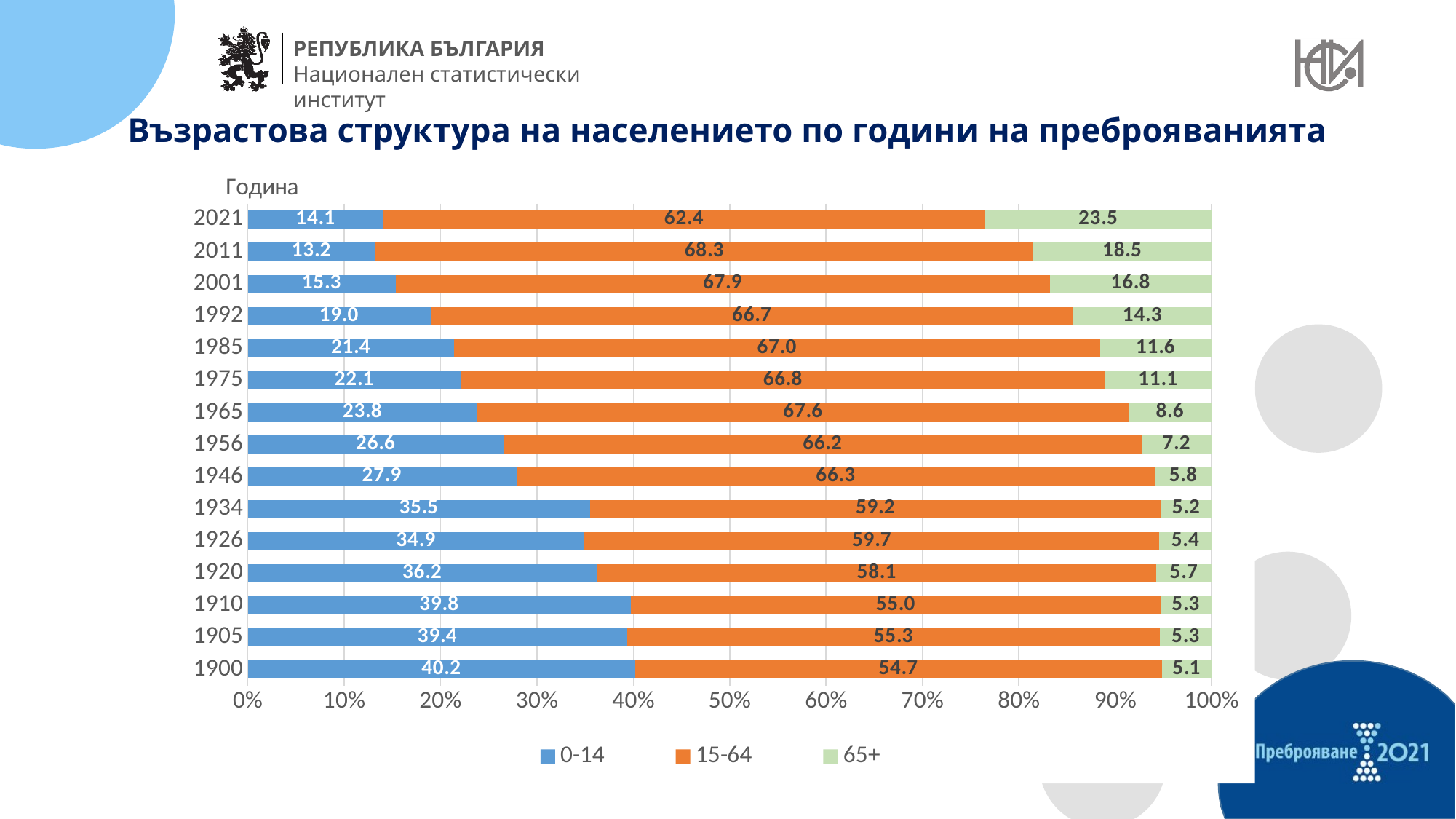
How many census years are shown on the chart? 15 What is the value for the 15-64 group in 1992? 66.7 What type of chart is shown on the slide? Stacked bar chart In which year is the 15-64 share the highest? 2011 Does the 0-14 share rise or fall from 1900 to 2021 (bottom to top of the chart)? Falls What is the difference between the 65+ values for 2021 and 2011? 5.0 What is the value for the 65+ group in 2021? 23.5 Which is larger: the 0-14 value for 1985 or for 1992? 1985 How many series does the legend list? 3 In which year is the 65+ share the highest? 2021 In which year is the 0-14 share the lowest? 2011 What is the value for the 0-14 group in 1900? 40.2